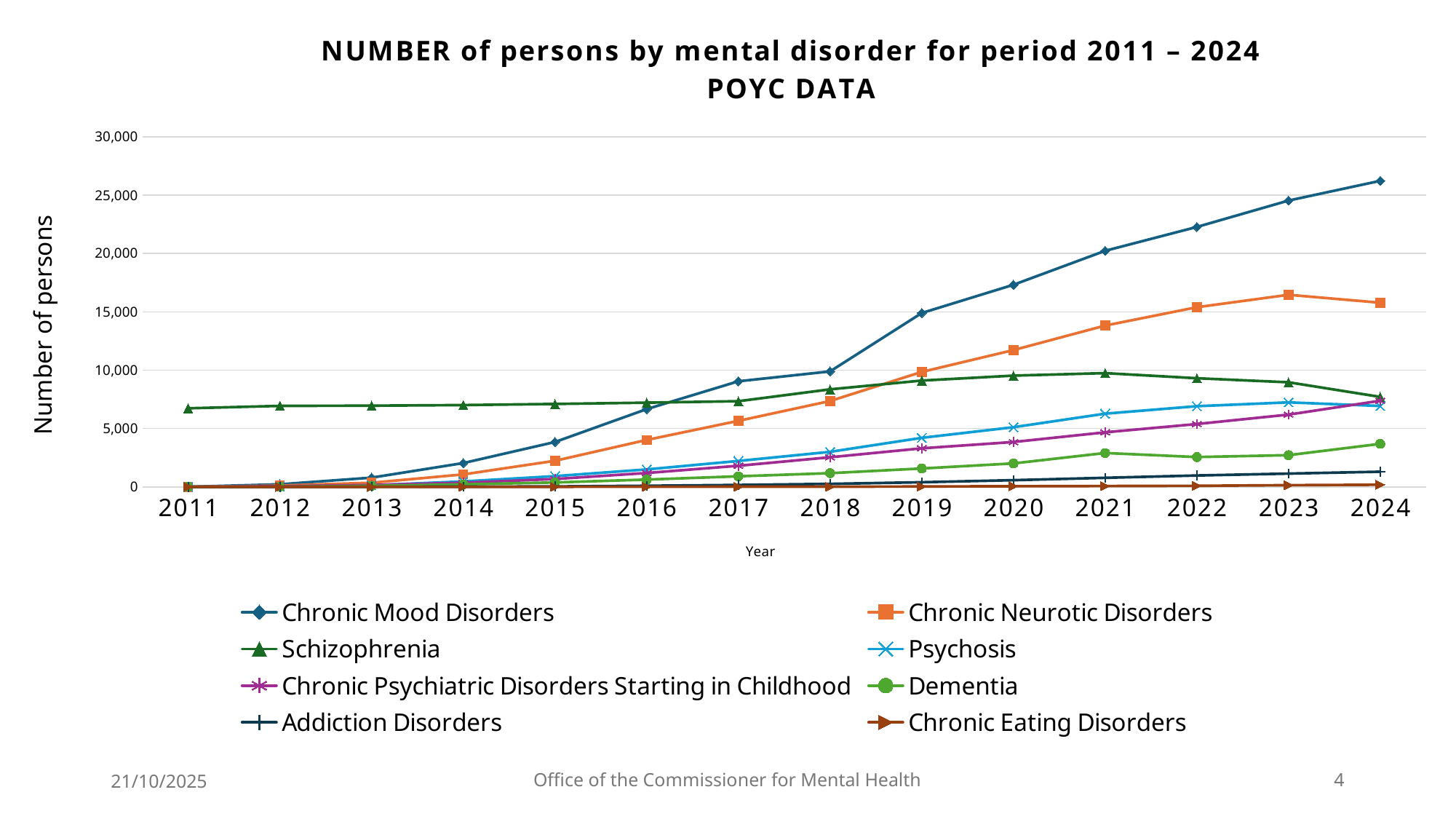
Is the value for Dementia in 2024 greater or less than 5,000? less Which series has the highest value in 2024? Chronic Mood Disorders Is the value for Chronic Neurotic Disorders in 2023 greater or less than 15,000? greater In 2011, which is larger: Schizophrenia or Chronic Mood Disorders? Schizophrenia How many series does the legend list? 8 What kind of chart is shown on the slide? Line chart What is the title of the y axis? Number of persons Which series has the lowest value in 2024? Chronic Eating Disorders In 2024, which is larger: Psychosis or Dementia? Psychosis Do the values for Chronic Mood Disorders rise or fall from 2011 to 2024? rise How many years are plotted along the x axis? 14 Is the value for Chronic Mood Disorders in 2024 greater or less than 25,000? greater